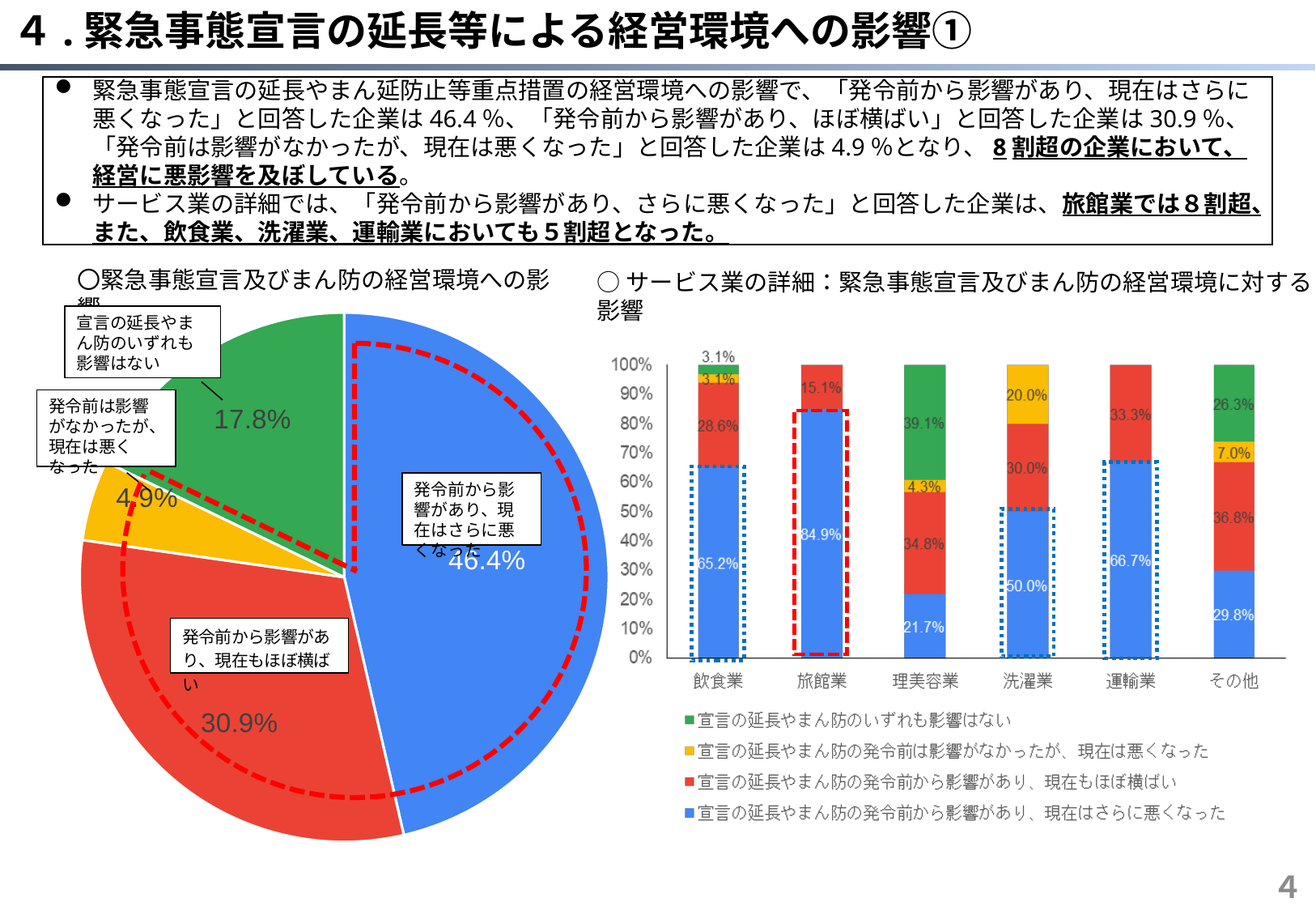
左の円グラフで、「発令前から影響があり、現在はさらに悪くなった」と「発令前から影響があり、現在もほぼ横ばい」の差は何ポイントですか？ 15.5% 右のサービス業の詳細のグラフで、「発令前から影響があり、現在はさらに悪くなった」の割合が最も高い業種はどれですか？ 旅館業 右のサービス業の詳細のグラフで、飲食業と運輸業では「発令前から影響があり、現在はさらに悪くなった」の割合はどちらが大きいですか？ 運輸業 右のサービス業の詳細のグラフで、旅館業の「発令前から影響があり、現在はさらに悪くなった」の割合は何％ですか？ 84.9% 左の円グラフで、最も割合が小さい区分はどれですか？ 発令前は影響がなかったが、現在は悪くなった 左の円グラフには区分がいくつありますか？ 4 右のサービス業の詳細のグラフの凡例には系列がいくつありますか？ 4 右のサービス業の詳細のグラフで、「発令前から影響があり、現在はさらに悪くなった」の割合が最も低い業種はどれですか？ 理美容業 左の円グラフで、「発令前から影響があり、現在はさらに悪くなった」の割合は何％ですか？ 46.4% 左の円グラフで、「宣言の延長やまん防のいずれも影響はない」の割合は何％ですか？ 17.8% 右のサービス業の詳細のグラフで、理美容業の「宣言の延長やまん防のいずれも影響はない」の割合は何％ですか？ 39.1% 右のサービス業の詳細のグラフはどの種類のグラフですか？ 積み上げ棒グラフ